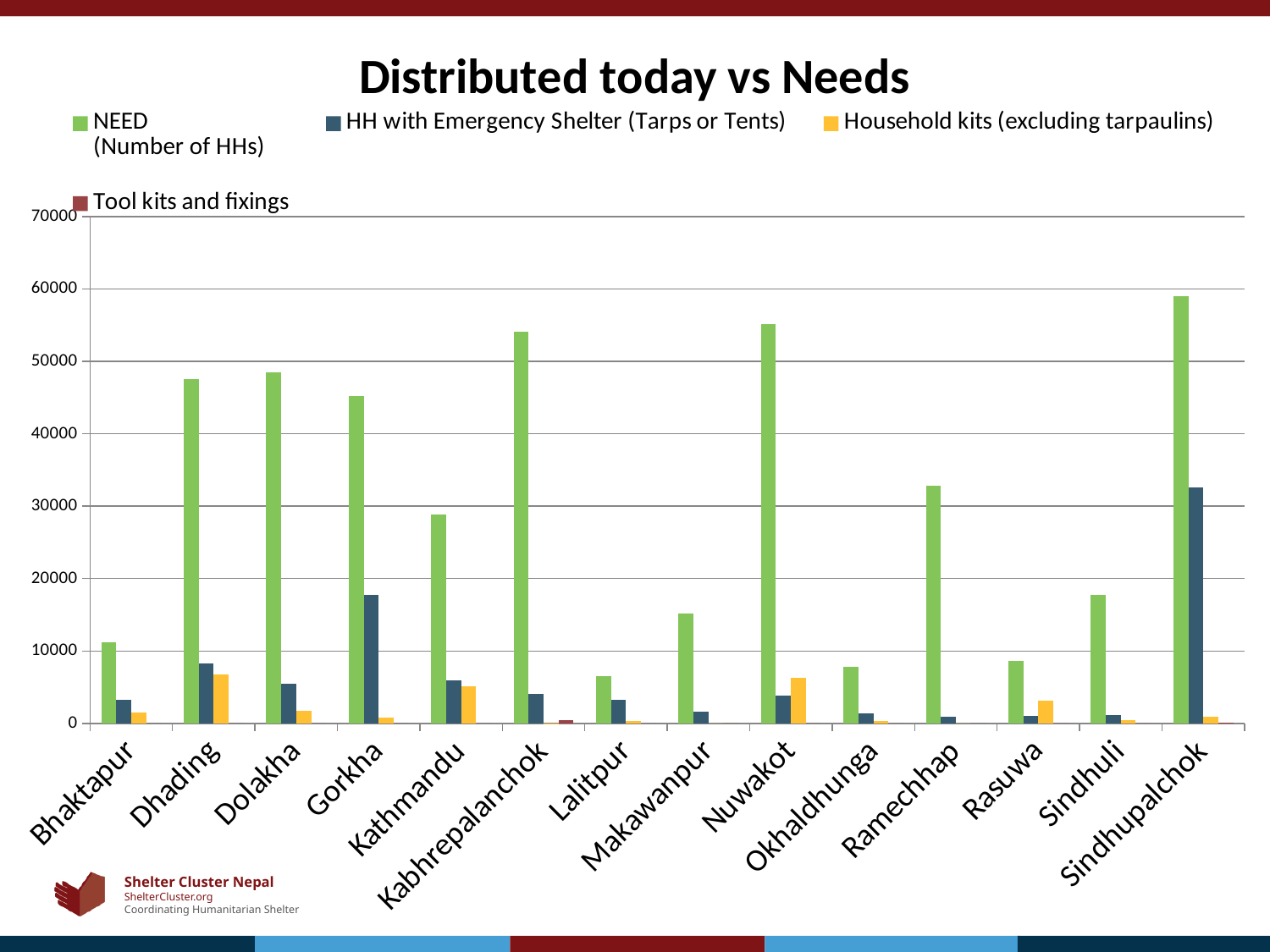
Which district has the lowest NEED (Number of HHs)? Lalitpur What is the title of the chart? Distributed today vs Needs Which colour represents the NEED (Number of HHs) series? green Which district has the highest value for HH with Emergency Shelter (Tarps or Tents)? Sindhupalchok Which district has the larger NEED value, Ramechhap or Sindhuli? Ramechhap How many districts are shown on the x axis? 14 Which district has the highest NEED (Number of HHs)? Sindhupalchok Is the NEED value for Nuwakot greater or less than 50000? greater Is the NEED value for Kathmandu greater or less than 20000? greater Is the HH with Emergency Shelter value for Gorkha greater or less than 10000? greater What type of chart is shown on the slide? bar chart How many series does the legend list? 4